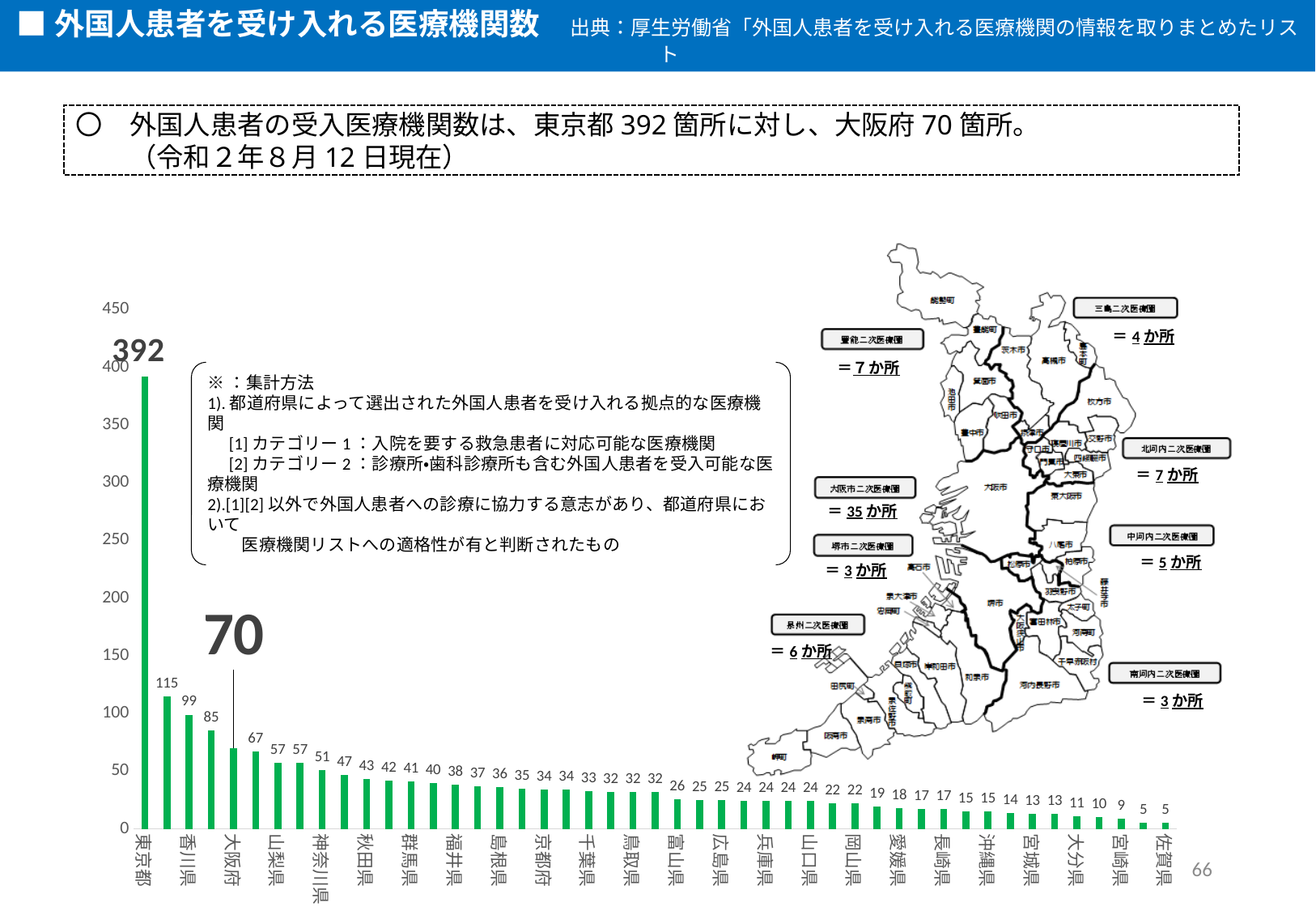
What is the value for 東京都 in the bar chart? 392 What is the value for 香川県 in the bar chart? 99 Which has a larger value, 東京都 or 大阪府? 東京都 Do the values rise or fall from left to right along the x axis? fall Is the value for 東京都 greater or less than 350? greater What is the highest tick value shown on the vertical axis of the bar chart? 450 What is the value for 大阪府 in the bar chart? 70 What is the difference between the values for 東京都 and 大阪府? 322 Which prefecture has the highest value in the bar chart? 東京都 What is the lowest value shown in the bar chart? 5 Is the value for 大阪府 greater or less than 100? less What kind of chart is shown on the slide? bar chart